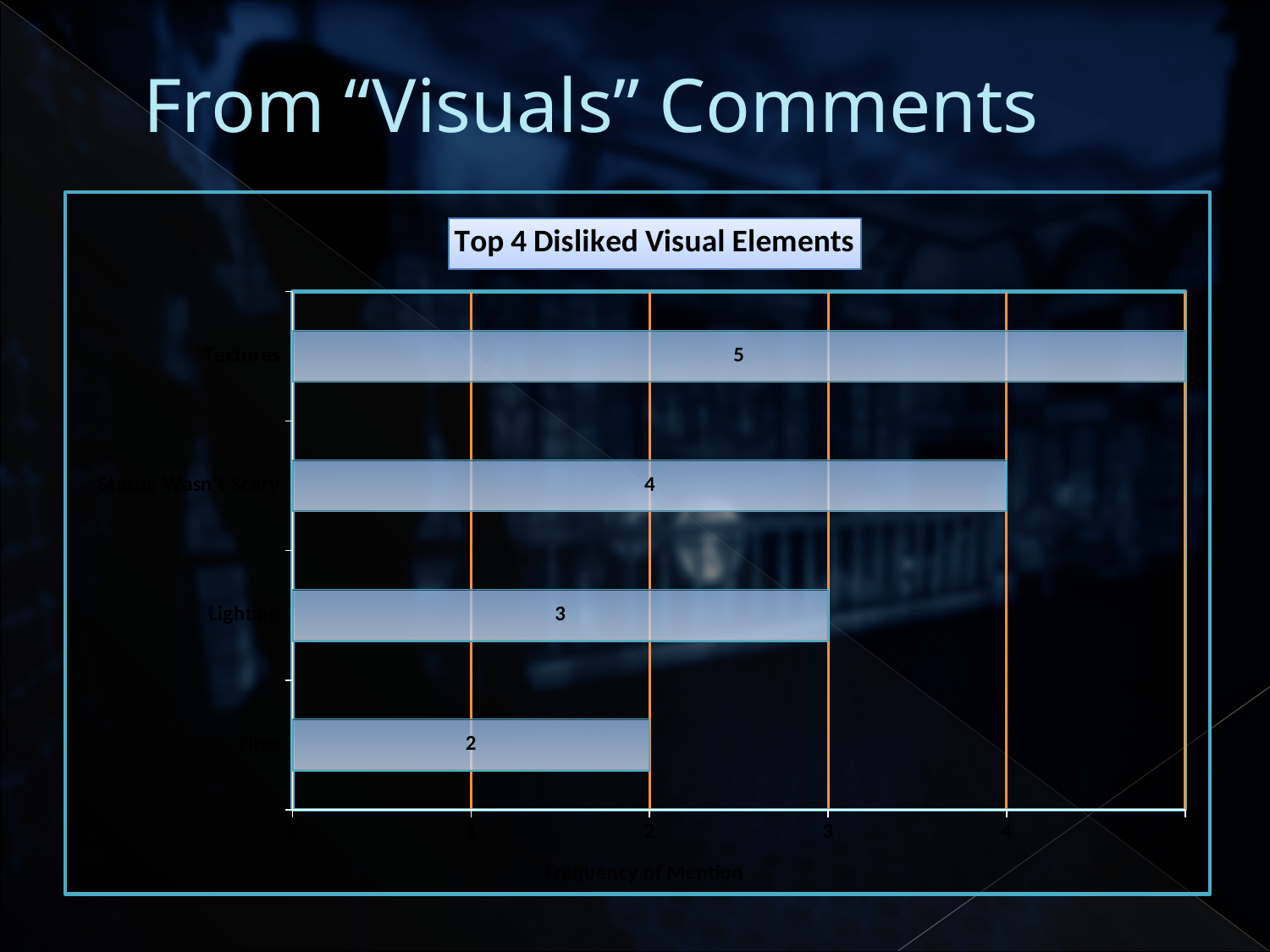
Which category has the highest frequency of mention? Textures What is the value for Textures? 5 What is the difference between the values for Textures and Fires? 3 What type of chart is shown on the slide? bar chart What is the label of the horizontal axis? Frequency of Mention What is the title of the chart? Top 4 Disliked Visual Elements What is the value for Fires? 2 Which category has the lowest frequency of mention? Fires What is the value for Lighting? 3 How many categories are shown in the chart? 4 Which has a larger value, Lighting or Statue Wasn't Scary? Statue Wasn't Scary What is the value for Statue Wasn't Scary? 4